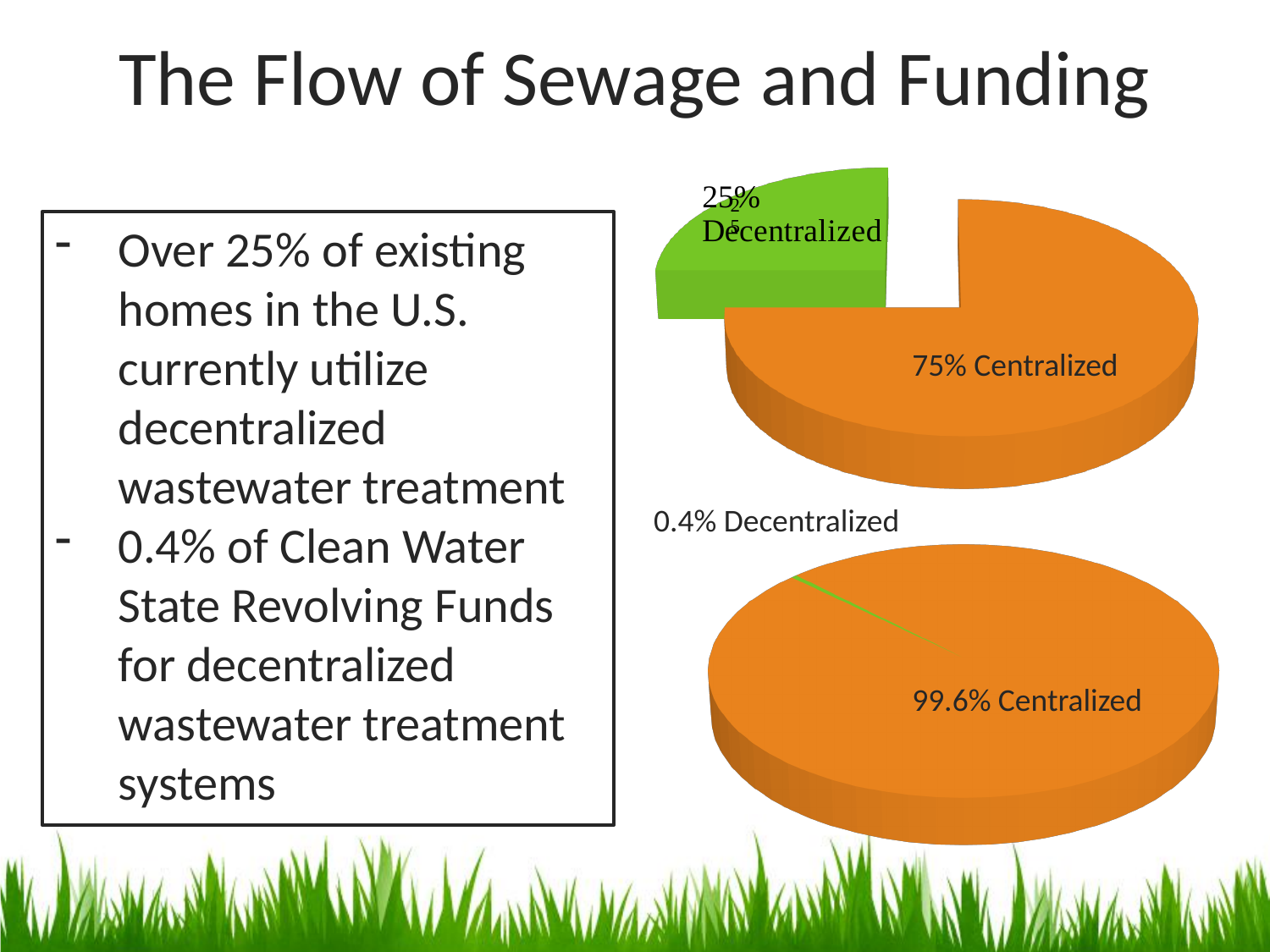
What kind of chart is the top chart on the right of the slide? pie chart In the top pie chart, what share is labelled Centralized? 75% In the bottom pie chart, which slice is the smallest? Decentralized How many slices does the top pie chart have? 2 In the bottom pie chart, what share is labelled Centralized? 99.6% In the top pie chart, what is the difference between the Centralized and Decentralized shares? 50% In the top pie chart, what colour is the Decentralized slice? green What kind of chart is the bottom chart on the right of the slide? pie chart In the bottom pie chart, what is the difference between the Centralized and Decentralized shares? 99.2% In the bottom pie chart, what share is labelled Decentralized? 0.4% In the top pie chart, which slice is larger, Centralized or Decentralized? Centralized In the top pie chart, what share is labelled Decentralized? 25%